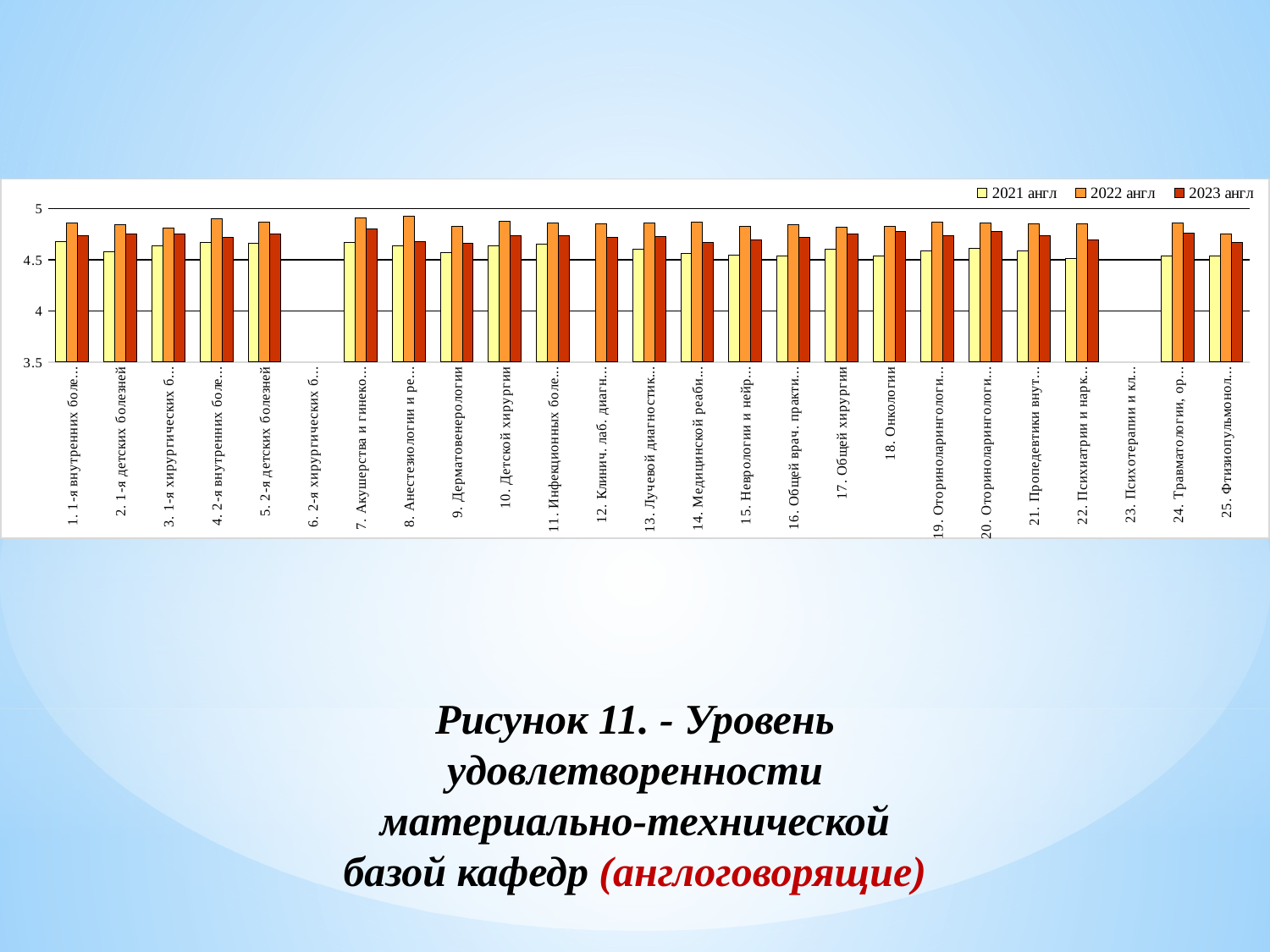
Is the value for 2021 англ for "9. Дерматовенерологии" greater or less than 4? greater Is the value for 2021 англ for "18. Онкологии" greater or less than 5? less What kind of chart is shown on the slide? bar chart What is the caption given below the chart? Рисунок 11. - Уровень удовлетворенности материально-технической базой кафедр (англоговорящие) For "2. 1-я детских болезней", which series has the larger value, 2021 англ or 2023 англ? 2023 англ Is the value for 2023 англ for "15. Неврологии и нейр..." greater or less than 4.5? greater How many series does the legend list? 3 How many categories are listed along the x axis of the chart? 25 For "10. Детской хирургии", which series has the larger value, 2021 англ or 2022 англ? 2022 англ For "10. Детской хирургии", which series has the lowest value? 2021 англ What are the legend entries of the chart? 2021 англ, 2022 англ, 2023 англ